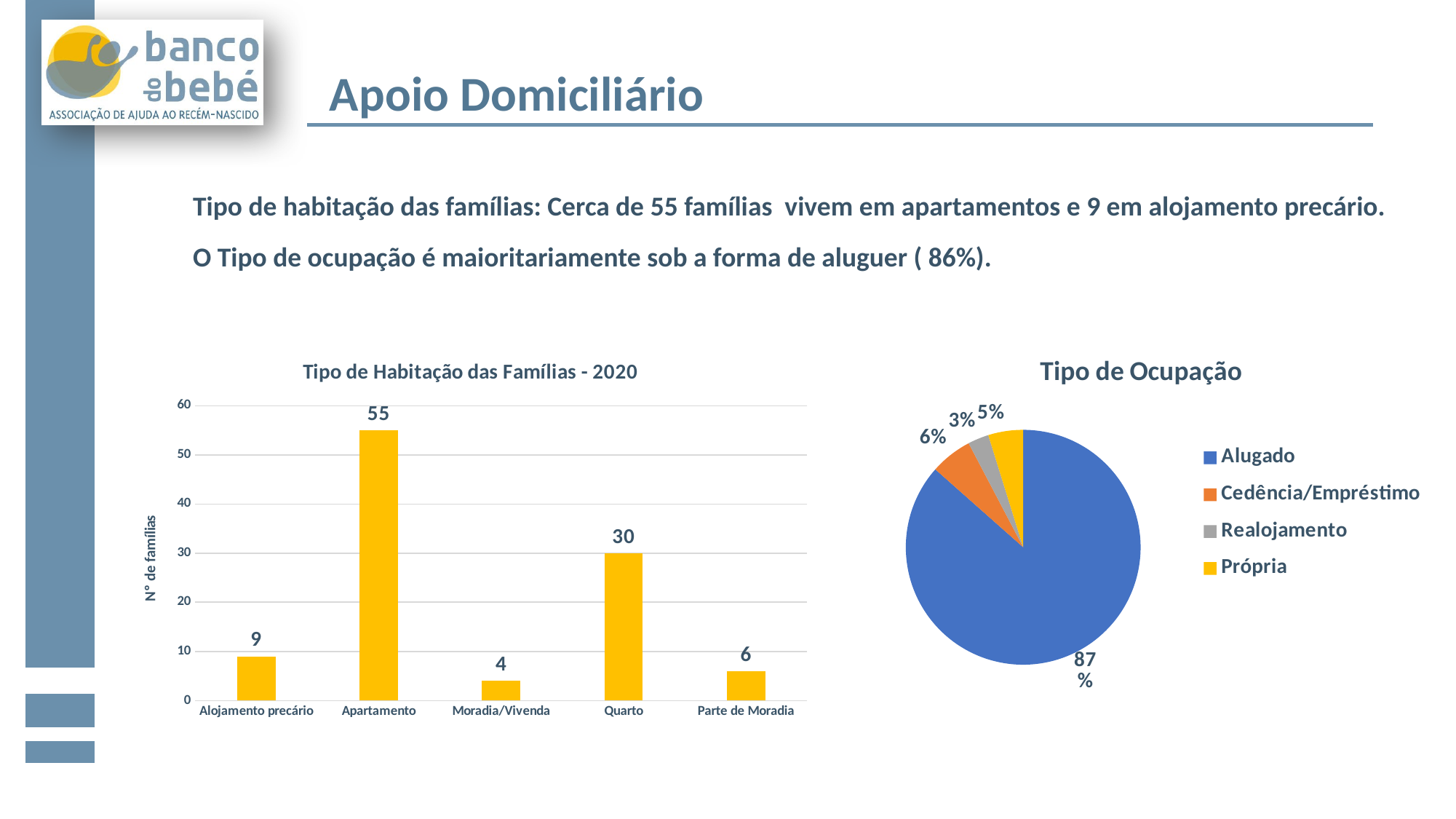
In the 'Tipo de Habitação das Famílias - 2020' chart, which category has the highest value? Apartamento What is the y-axis title of the 'Tipo de Habitação das Famílias - 2020' chart? Nº de famílias In the 'Tipo de Habitação das Famílias - 2020' chart, what is the value for Apartamento? 55 In the 'Tipo de Ocupação' pie chart, what share does Realojamento have? 3% How many entries does the legend of the 'Tipo de Ocupação' pie chart list? 4 In the 'Tipo de Habitação das Famílias - 2020' chart, which is larger: Alojamento precário or Parte de Moradia? Alojamento precário In the 'Tipo de Habitação das Famílias - 2020' chart, what is the value for Quarto? 30 In the 'Tipo de Habitação das Famílias - 2020' chart, what is the difference between Apartamento and Quarto? 25 In the 'Tipo de Habitação das Famílias - 2020' chart, which category has the lowest value? Moradia/Vivenda How many categories are shown in the 'Tipo de Habitação das Famílias - 2020' chart? 5 What kind of chart is 'Tipo de Habitação das Famílias - 2020'? Bar chart In the 'Tipo de Ocupação' pie chart, what share does Alugado have? 87%